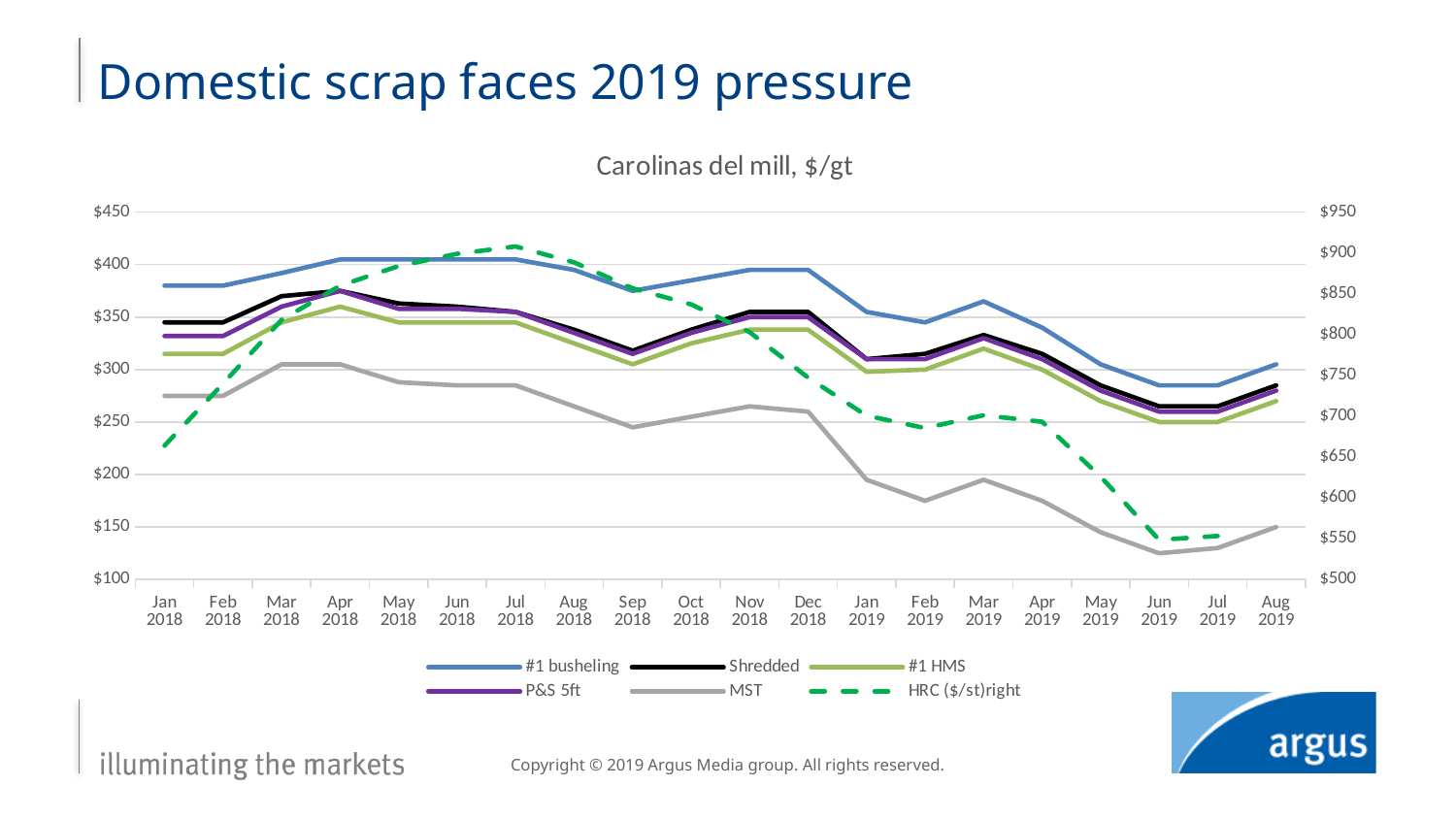
How many series does the chart legend list? 6 Which series is plotted against the right-hand axis? HRC ($/st) Does the #1 busheling series overall rise or fall from Jan 2018 to Aug 2019? fall In which month does the HRC series reach its highest value? Jul 2018 What is the title of the chart? Carolinas del mill, $/gt Is the value for #1 busheling in Aug 2019 greater or less than $350? less Is the value for HRC in Jul 2018 greater or less than $850 on the right axis? greater In Jan 2018, which is higher: #1 busheling or MST? #1 busheling What kind of chart is shown on the slide? line chart How many monthly points are plotted along the x axis? 20 Is the value for MST in Jun 2019 greater or less than $150? less